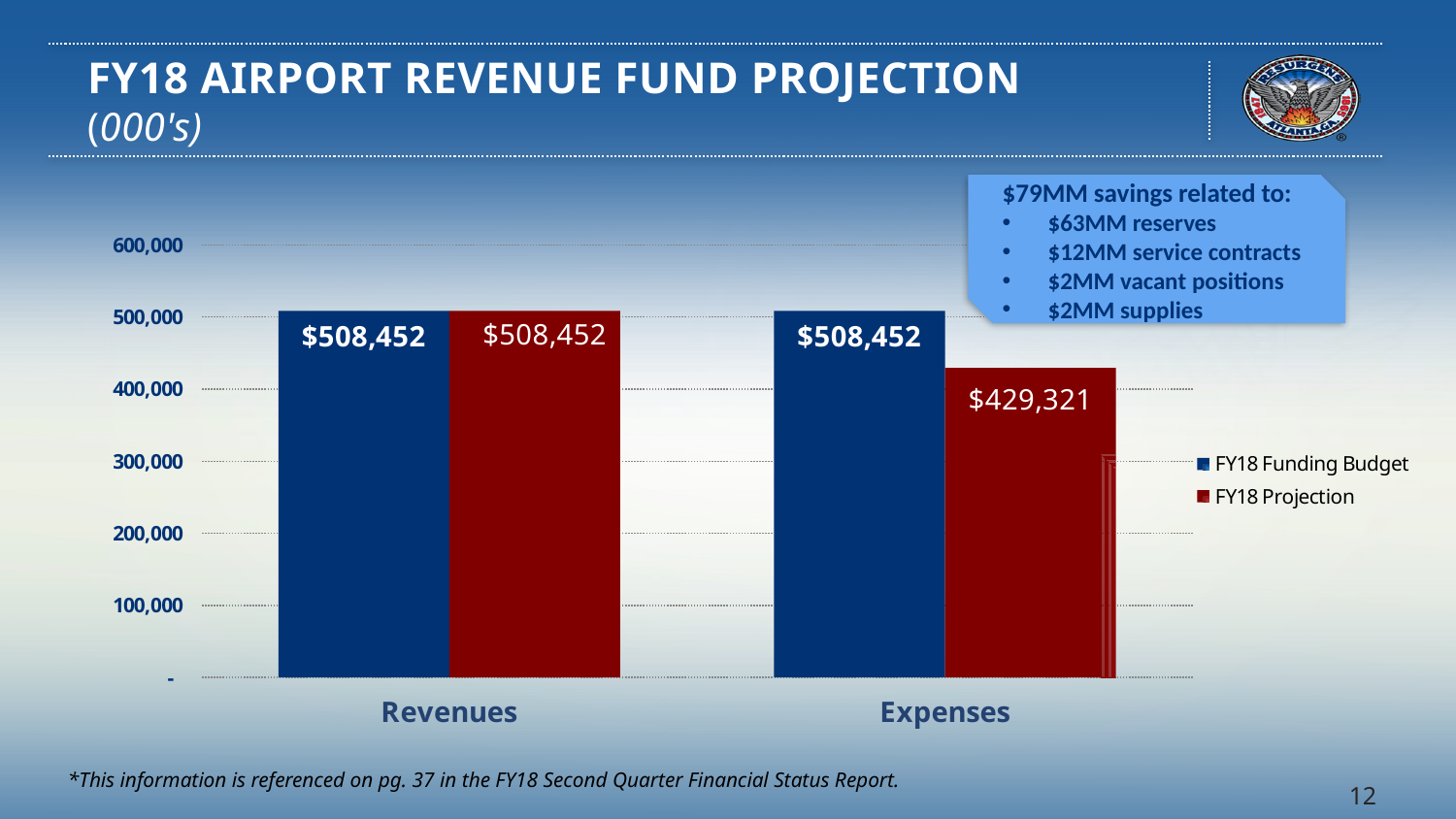
What is the FY18 Projection value for Expenses? $429,321 How many categories are shown on the x axis? 2 Which is larger for Expenses: the FY18 Funding Budget or the FY18 Projection? FY18 Funding Budget What kind of chart is shown on the slide? Bar chart Which series is shown in red in the legend? FY18 Projection What is the difference between the FY18 Funding Budget and the FY18 Projection for Expenses? $79,131 What is the FY18 Projection value for Revenues? $508,452 What is the title of the chart on the slide? FY18 AIRPORT REVENUE FUND PROJECTION (000's) Is the FY18 Projection value for Expenses greater or less than 400,000? greater What is the FY18 Funding Budget value for Revenues? $508,452 How many series does the legend list? 2 What is the FY18 Funding Budget value for Expenses? $508,452